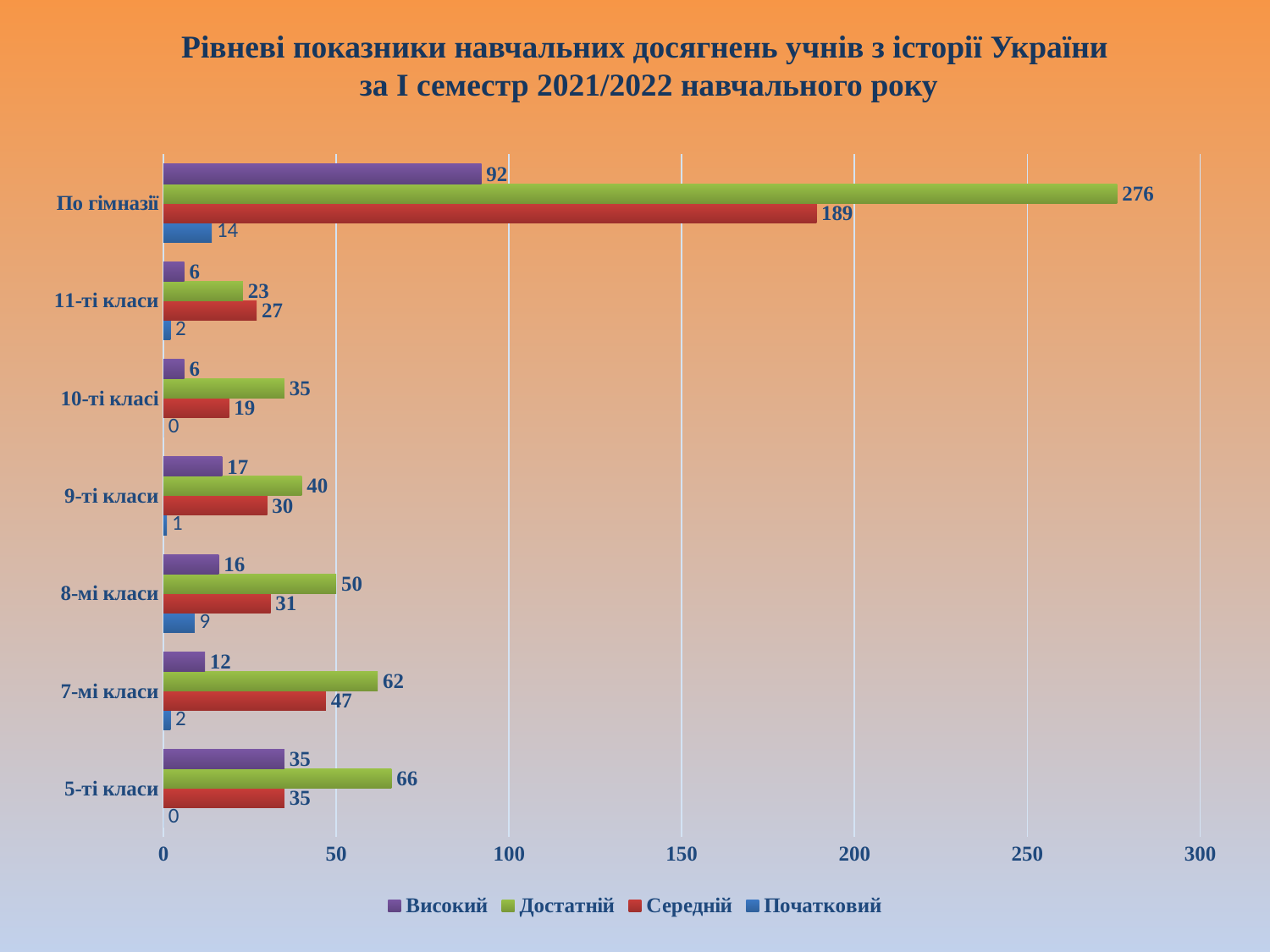
Among the class categories (excluding По гімназії), which has the highest Достатній value? 5-ті класи How many categories are shown on the y axis? 7 Which category has the lowest Високий value? 11-ті класи and 10-ті класі (both 6) What is the value of Середній for 7-мі класи? 47 What kind of chart is shown on the slide? Bar chart How many series does the legend list? 4 What is the value of Початковий for 8-мі класи? 9 What is the value of Достатній for По гімназії? 276 Is the value of Високий for По гімназії greater or less than 100? less What is the difference between the Достатній and Середній values for По гімназії? 87 Which is larger for 11-ті класи: Достатній or Середній? Середній What is the value of Високий for 5-ті класи? 35